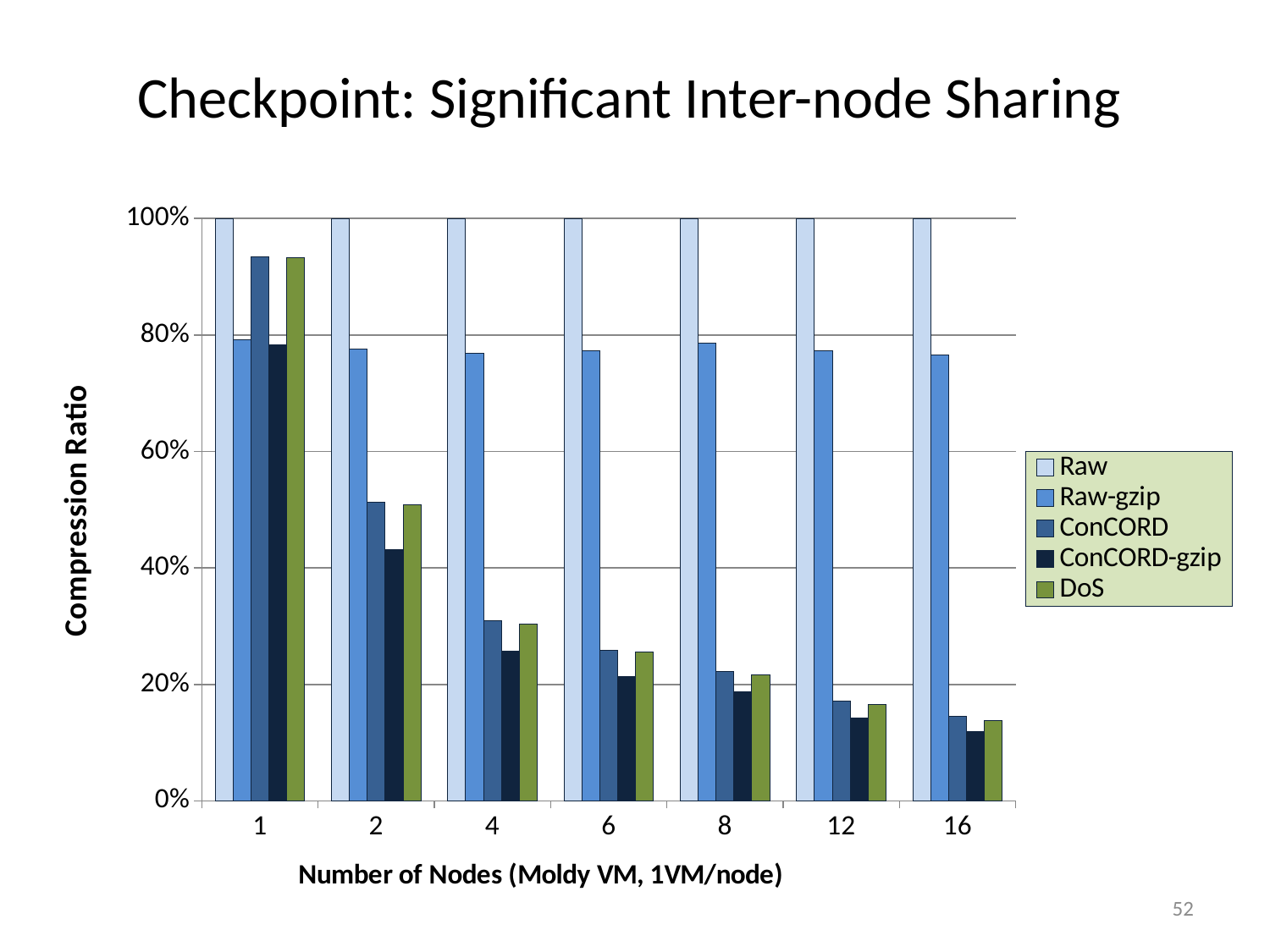
Is the value for ConCORD-gzip at 16 nodes greater or less than 20%? less Which series has the highest value at 8 nodes? Raw Which series has the lowest value at 2 nodes? ConCORD-gzip What is the title of the x axis? Number of Nodes (Moldy VM, 1VM/node) Do the ConCORD values rise or fall as the number of nodes increases? fall How many series does the legend list? 5 What kind of chart is shown on the slide? bar chart Is the value for Raw-gzip at 1 node greater or less than 60%? greater At 4 nodes, which is larger: Raw-gzip or ConCORD? Raw-gzip Is the value for ConCORD at 2 nodes greater or less than 40%? greater How many node-count categories are shown on the x axis? 7 What is the compression ratio for Raw at 1 node? 100%